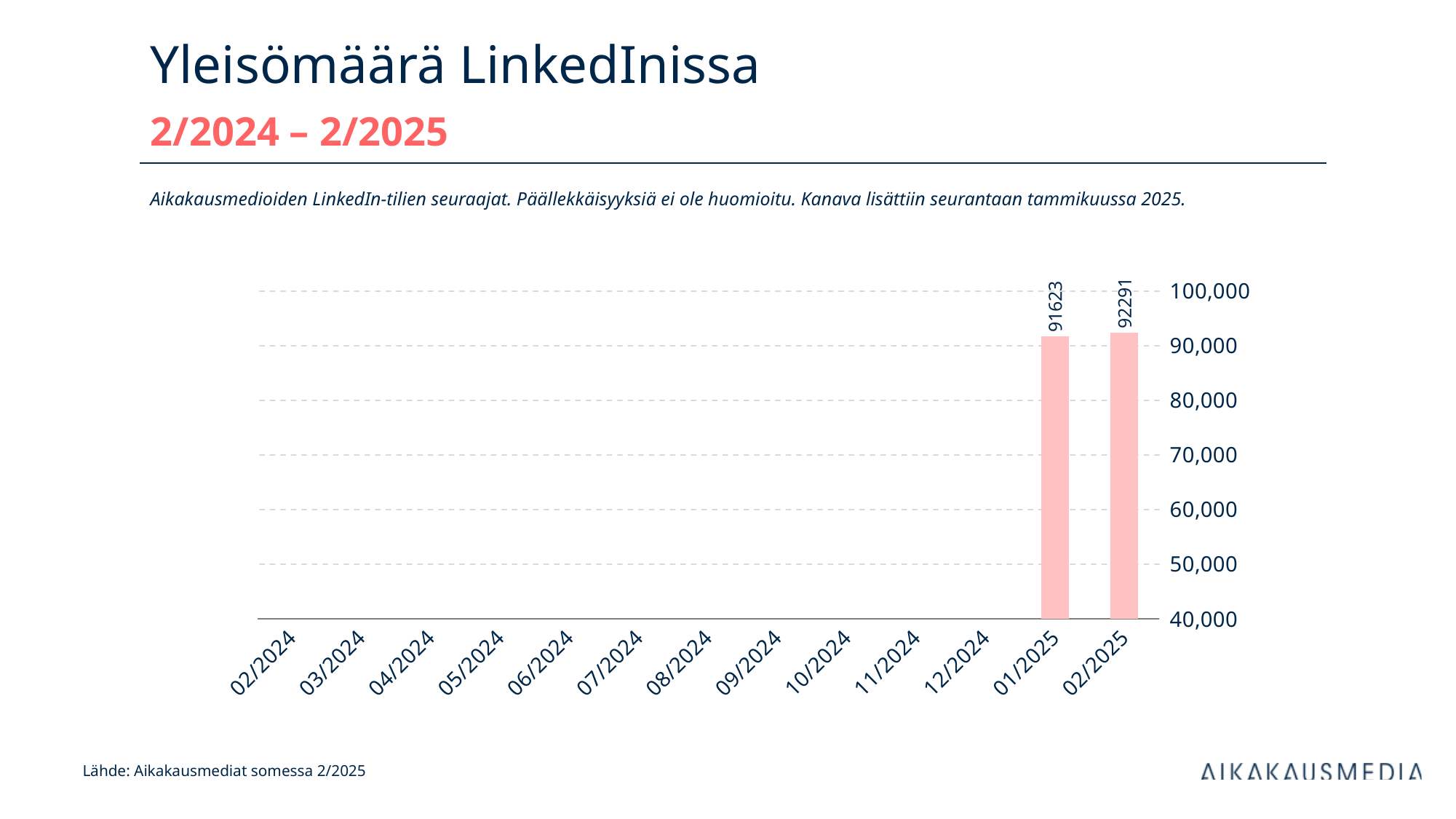
What kind of chart is shown? bar chart How many month categories are shown on the x axis? 13 What is the value for 02/2025? 92291 Is the value for 02/2025 greater or less than 100,000? less How many months have a bar plotted? 2 What is the difference between the values for 02/2025 and 01/2025? 668 What is the value for 01/2025? 91623 Is the value for 01/2025 greater or less than 90,000? greater Do the values rise or fall from 01/2025 to 02/2025? rise Which is larger, the value for 01/2025 or the value for 02/2025? 02/2025 Which month has the highest value? 02/2025 What is the title of the slide? Yleisömäärä LinkedInissa